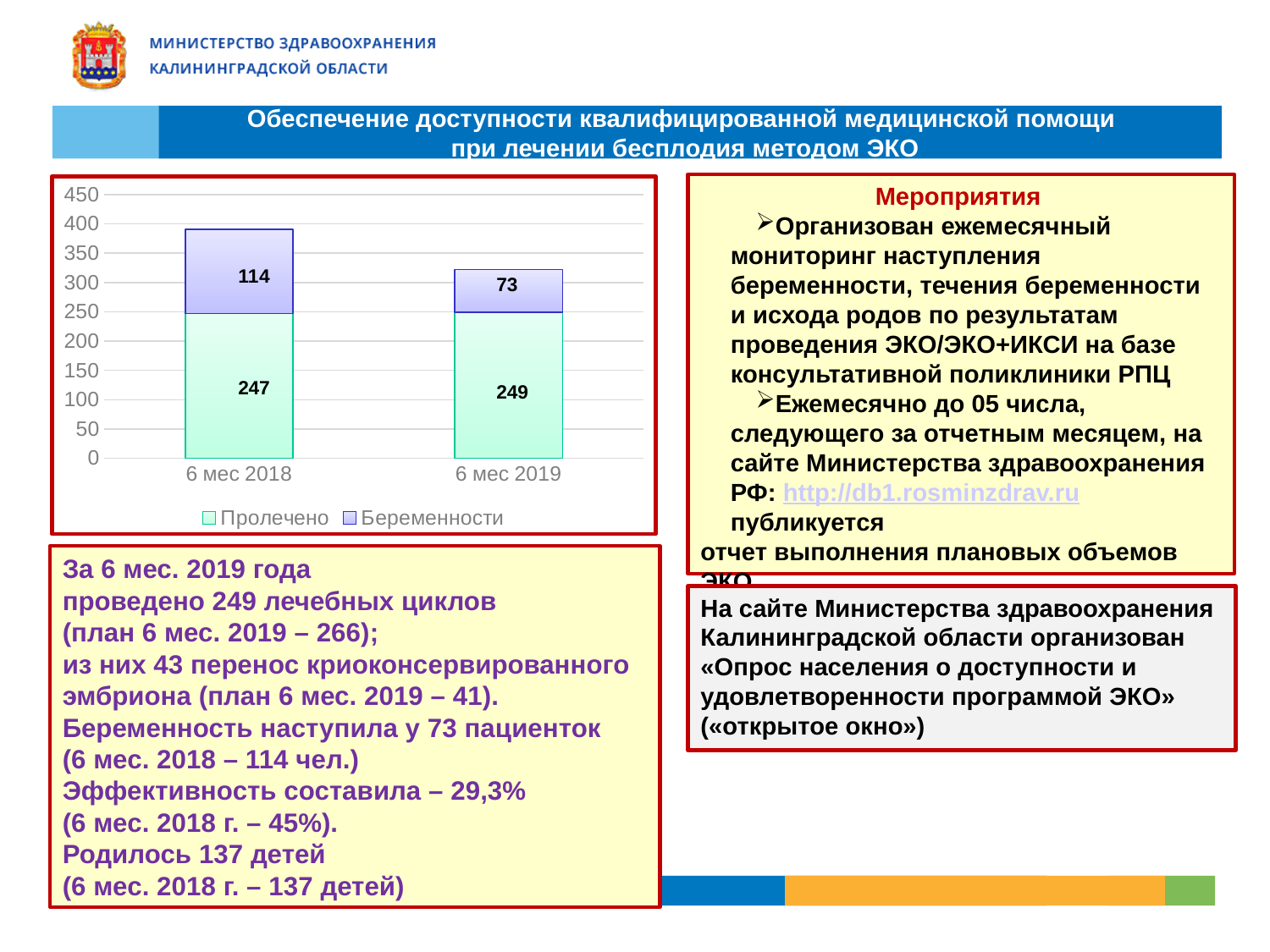
What is the value for Пролечено in 6 мес 2018? 247 What is the value for Беременности in 6 мес 2019? 73 What is the total of the stacked bar for 6 мес 2018? 361 Which period has the higher Беременности value, 6 мес 2018 or 6 мес 2019? 6 мес 2018 What is the total of the stacked bar for 6 мес 2019? 322 How many categories are shown on the x axis? 2 Which series is shown in light green in the legend? Пролечено How many series does the legend list? 2 What kind of chart is shown on the slide? stacked bar chart What is the value for Пролечено in 6 мес 2019? 249 What is the difference between the Беременности values for 6 мес 2018 and 6 мес 2019? 41 What is the value for Беременности in 6 мес 2018? 114